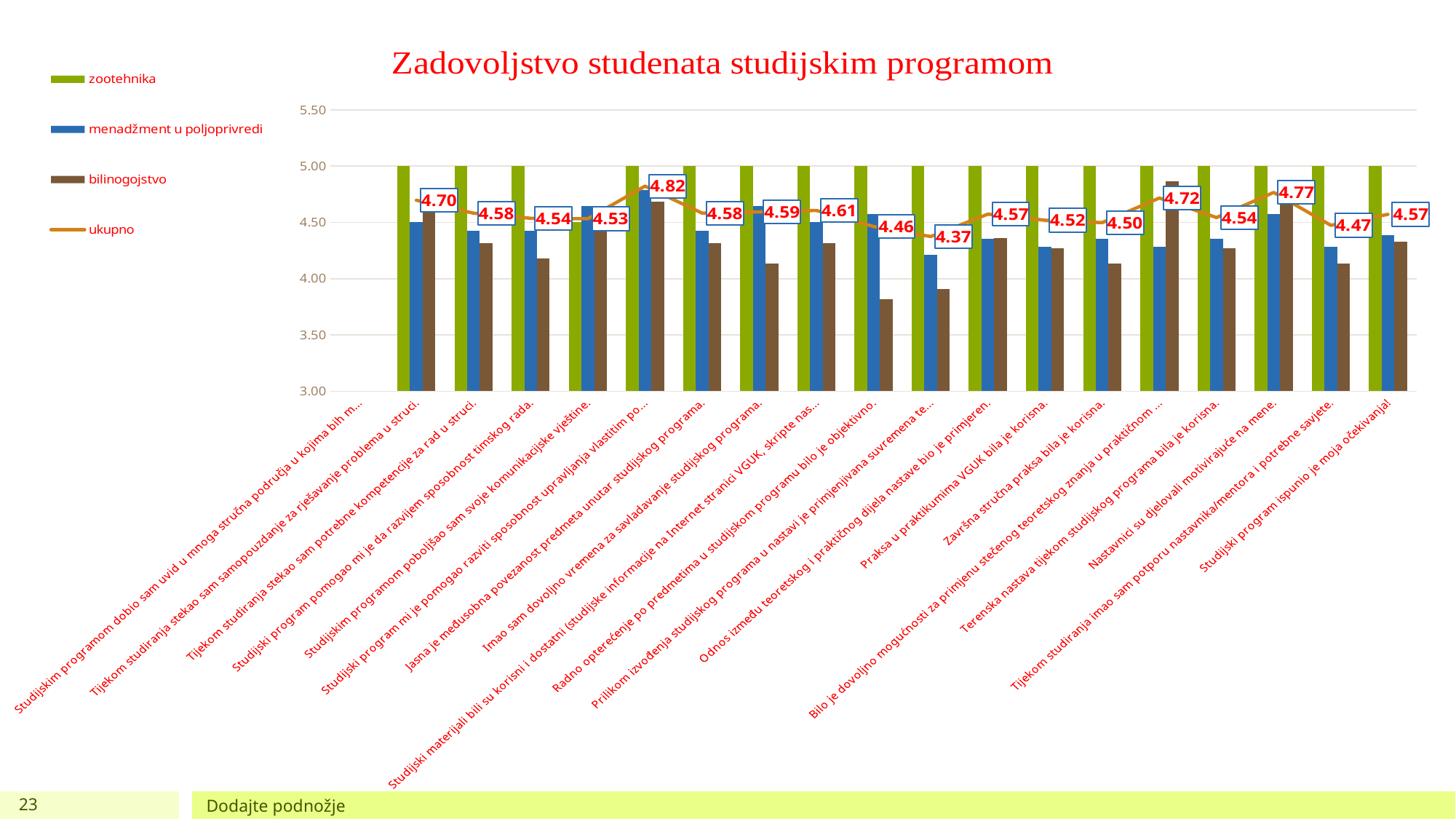
What is the ukupno value for "Završna stručna praksa bila je korisna."? 4.50 What is the zootehnika value for "Završna stručna praksa bila je korisna."? 5.00 How many series does the legend list? 4 Which category has the highest ukupno value? Studijski program mi je pomogao razviti sposobnost upravljanja vlastitim po... What is the difference between the highest and lowest ukupno values? 0.45 What is the title of the chart? Zadovoljstvo studenata studijskim programom What kind of chart is shown on the slide? bar chart with a line For "Bilo je dovoljno mogućnosti za primjenu stečenog teoretskog znanja u praktičnom ...", which is larger: menadžment u poljoprivredi or bilinogojstvo? bilinogojstvo Is the bilinogojstvo value for "Radno opterećenje po predmetima u studijskom programu bilo je objektivno." greater or less than 4.00? less What is the ukupno value for "Nastavnici su djelovali motivirajuće na mene."? 4.77 Which has the larger ukupno value: "Bilo je dovoljno mogućnosti za primjenu stečenog teoretskog znanja u praktičnom ..." or "Tijekom studiranja imao sam potporu nastavnika/mentora i potrebne savjete."? Bilo je dovoljno mogućnosti za primjenu stečenog teoretskog znanja u praktičnom ... Which category has the lowest ukupno value? Prilikom izvođenja studijskog programa u nastavi je primjenjivana suvremena te...